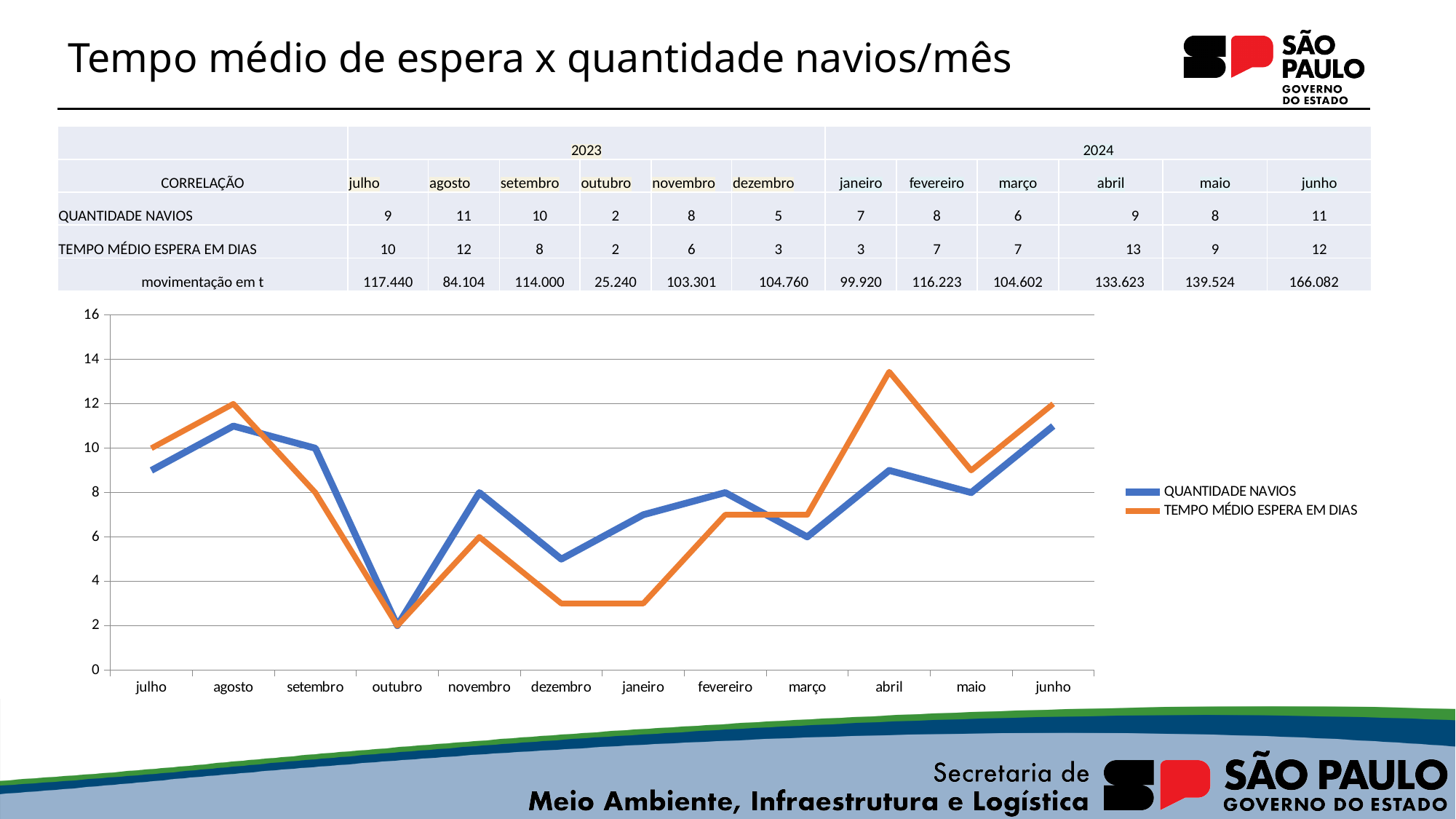
What kind of chart is shown on the slide? line chart What is the value of QUANTIDADE NAVIOS for outubro? 2 How many months are plotted along the x axis of the chart? 12 In janeiro, which series has the larger value, QUANTIDADE NAVIOS or TEMPO MÉDIO ESPERA EM DIAS? QUANTIDADE NAVIOS Is the value of TEMPO MÉDIO ESPERA EM DIAS for abril greater or less than 12? greater In which month is QUANTIDADE NAVIOS lowest? outubro In which month is TEMPO MÉDIO ESPERA EM DIAS highest? abril What colour is the line for TEMPO MÉDIO ESPERA EM DIAS? orange Does QUANTIDADE NAVIOS rise or fall from agosto to outubro? fall What is the value of TEMPO MÉDIO ESPERA EM DIAS for abril? 13 In abril, what is the difference between TEMPO MÉDIO ESPERA EM DIAS and QUANTIDADE NAVIOS? 4 How many series does the chart's legend list? 2